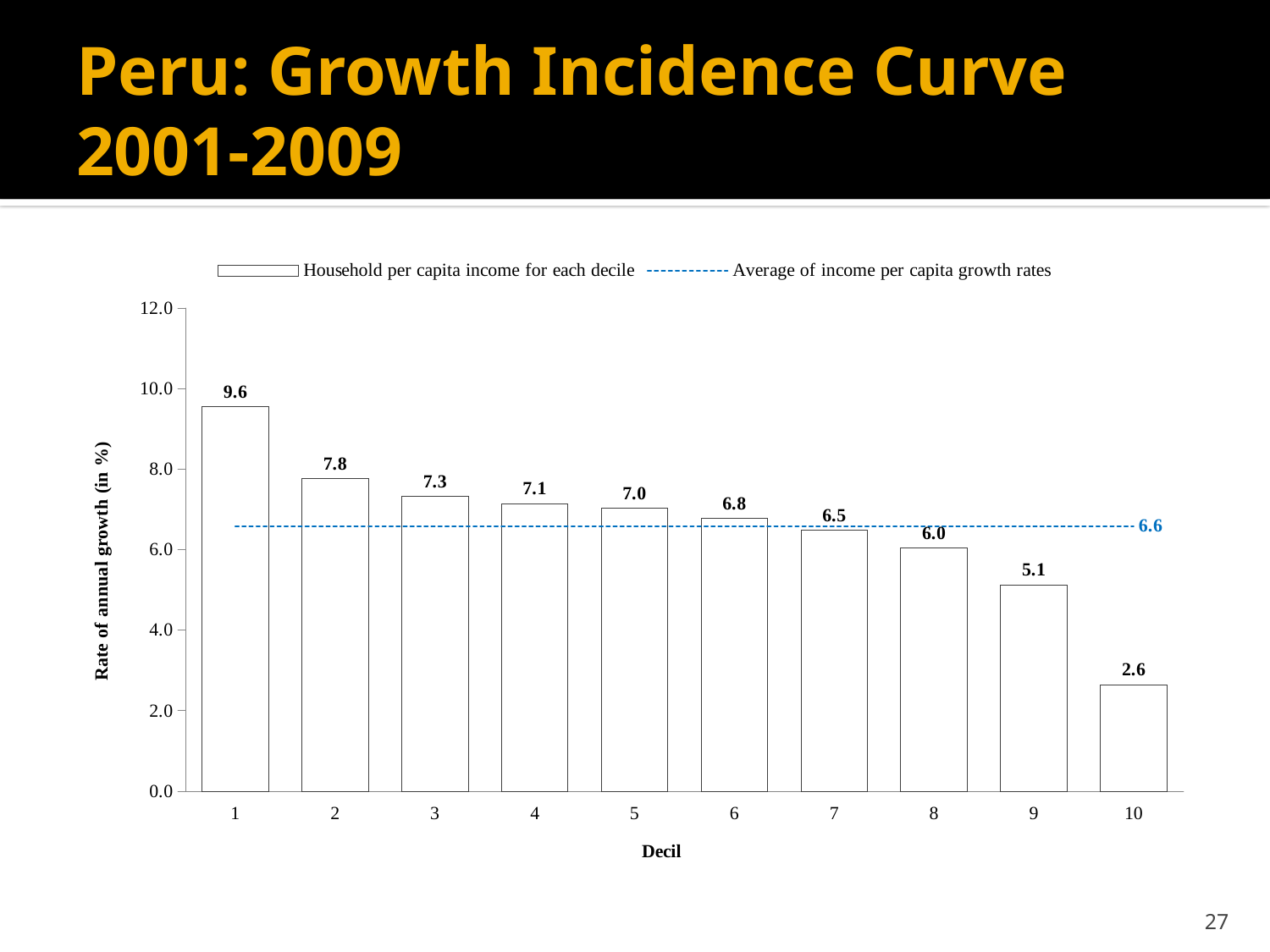
What is the difference between the growth rates of decile 1 and decile 10? 7.0 What is the value of the average of income per capita growth rates line? 6.6 How many deciles are shown on the x axis? 10 Which decile has the highest rate of annual growth? 1 What kind of chart is shown on the slide? Combination bar and line chart How many entries does the legend list? 2 What is the rate of annual growth for decile 1? 9.6 Which decile has the lowest rate of annual growth? 10 Which has a higher growth rate, decile 3 or decile 8? Decile 3 Do the growth rates rise or fall as the decile number increases? Fall What is the rate of annual growth for decile 10? 2.6 Is the value for decile 9 greater or less than 6.0? less